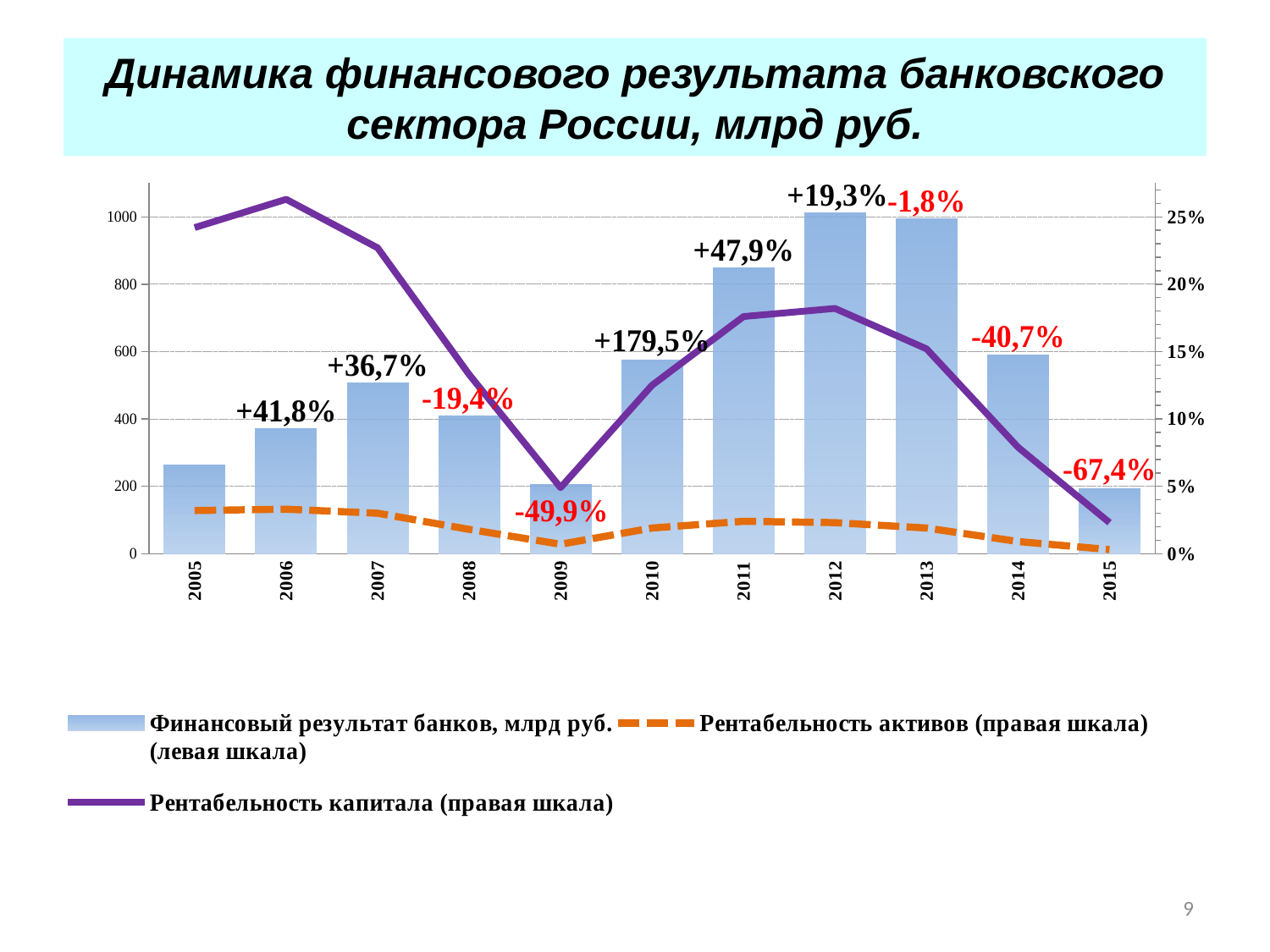
How many series does the legend list? 3 How many years are shown on the x axis of the chart? 11 What percentage change label is printed above the 2015 bar? -67,4% What kind of chart is shown on the slide? Combined bar and line chart Is the financial result bar for 2009 greater or less than 400? less Do the financial result bars rise or fall from 2012 to 2015? fall Is the return on equity (purple line) value for 2006 greater or less than 25%? greater Is the financial result bar for 2011 greater or less than 800? greater What percentage change label is printed above the 2009 bar? -49,9% What percentage change label is printed above the 2010 bar? +179,5% In which year does the return on equity (purple line) reach its highest point? 2006 Which is larger, the financial result bar for 2010 or for 2011? 2011